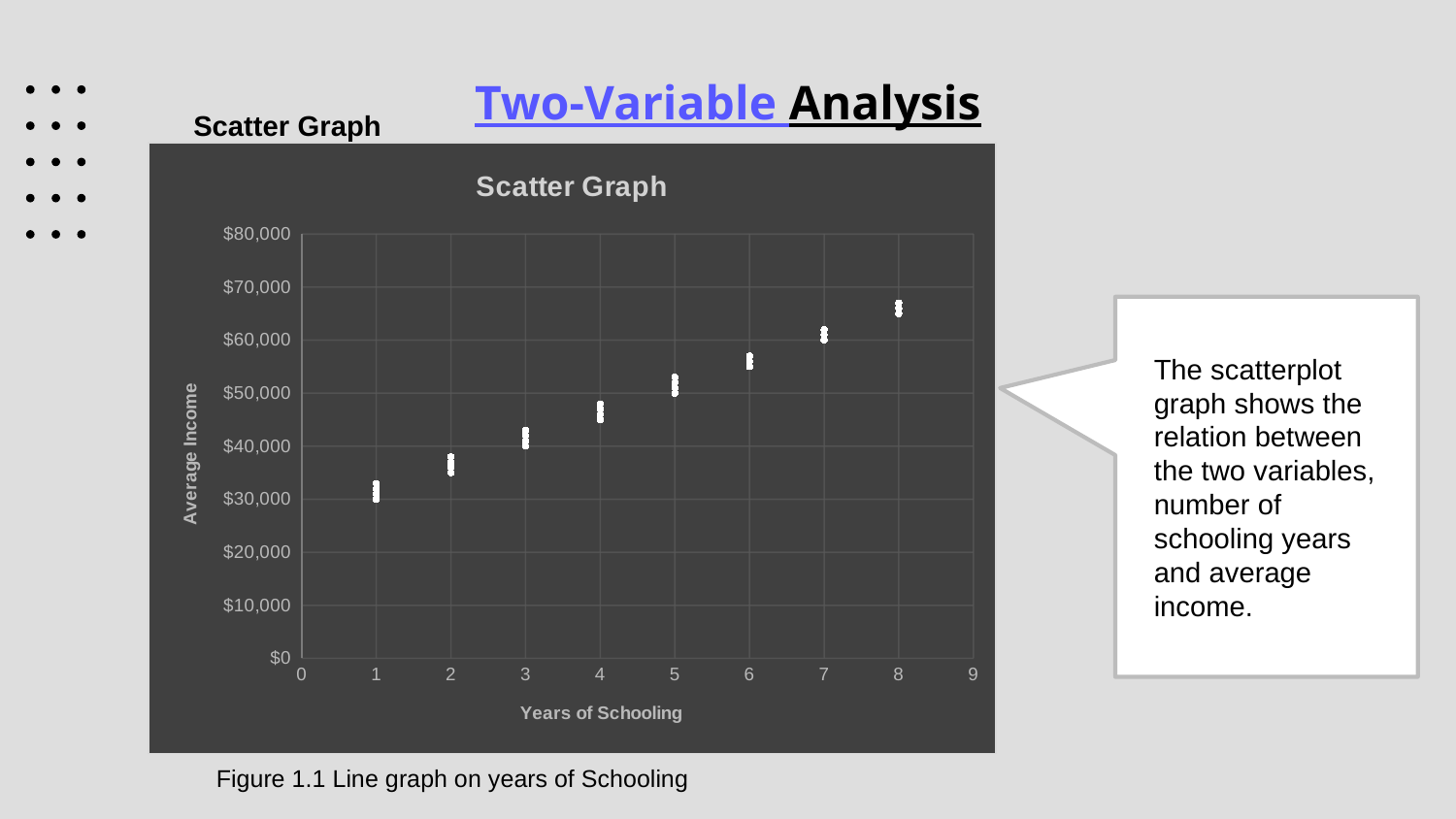
How many distinct values of years of schooling have points plotted? 8 What is the label of the x axis? Years of Schooling Which has higher average income points: 2 years of schooling or 7 years of schooling? 7 years of schooling Are the average income values for 1 year of schooling greater or less than $40,000? less Which years of schooling value has the highest average income points? 8 Are the average income values for 4 years of schooling greater or less than $50,000? less Which years of schooling value has the lowest average income points? 1 What is the title of the chart? Scatter Graph Are the average income values for 6 years of schooling greater or less than $50,000? greater Do the average income values rise or fall as years of schooling increase? Rise What kind of chart is shown on the slide? Scatter chart